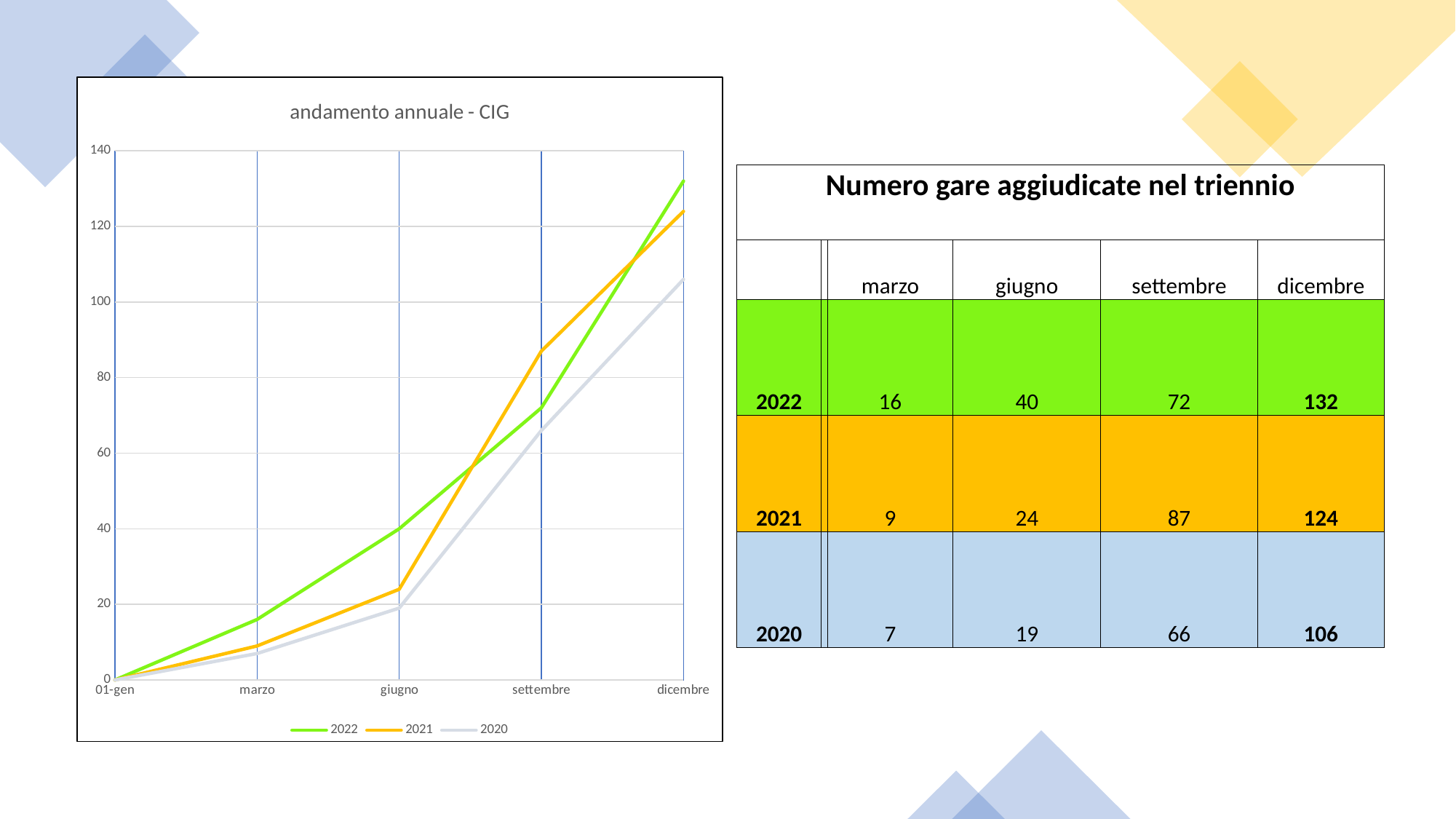
How many series does the legend of the "andamento annuale - CIG" chart list? 3 In the "andamento annuale - CIG" chart, which series is highest at dicembre? 2022 In the "andamento annuale - CIG" chart, does the 2022 line rise or fall from 01-gen to dicembre? rise What is the value of the 2022 series at dicembre in the "andamento annuale - CIG" chart, as printed in the table on the slide? 132 In the "andamento annuale - CIG" chart, is the value for 2020 at settembre greater or less than 80? less Using the values printed in the table, what is the difference between 2022 and 2021 at dicembre? 8 In the "andamento annuale - CIG" chart, which series is lowest at dicembre? 2020 In the "andamento annuale - CIG" chart, which is larger at settembre: 2021 or 2022? 2021 In the "andamento annuale - CIG" chart, is the value for 2022 at dicembre greater or less than 120? greater What colour is the 2021 line in the "andamento annuale - CIG" chart? orange How many points are on the x axis of the "andamento annuale - CIG" chart? 5 What kind of chart is "andamento annuale - CIG"? line chart